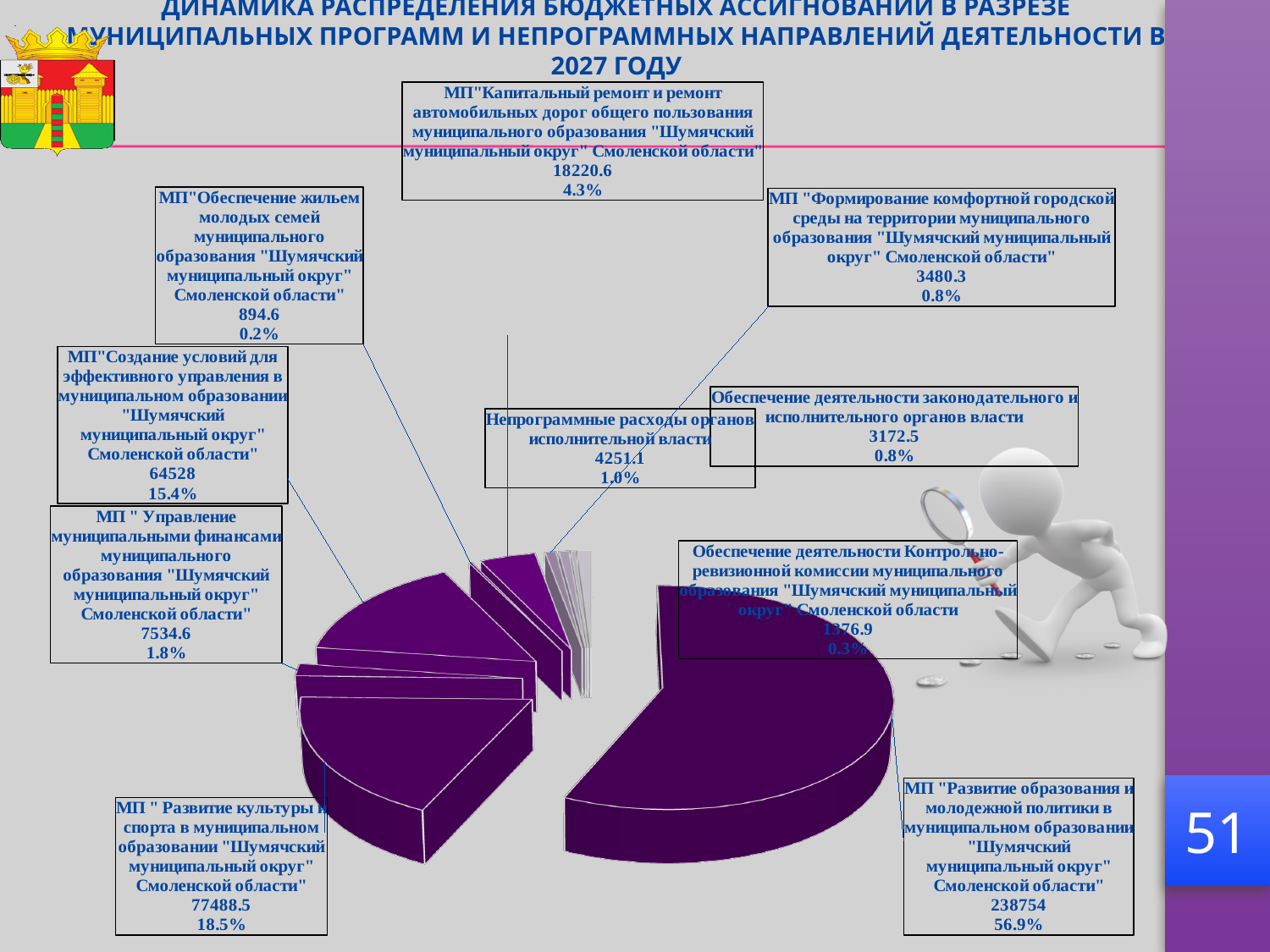
Which is larger: the value for МП "Управление муниципальными финансами" or the value for МП"Капитальный ремонт и ремонт автомобильных дорог"? МП"Капитальный ремонт и ремонт автомобильных дорог" What kind of chart is shown on the slide? Pie chart What share of the pie does МП "Развитие образования и молодежной политики" account for? 56.9% How many categories are shown in the pie chart? 10 What is the difference between the values for МП "Развитие образования и молодежной политики" (238754) and МП "Развитие культуры и спорта" (77488.5)? 161265.5 What is the value shown for МП "Формирование комфортной городской среды"? 3480.3 What share of the pie does МП"Создание условий для эффективного управления в муниципальном образовании" account for? 15.4% Which category has the smallest share of the pie? МП"Обеспечение жильем молодых семей муниципального образования "Шумячский муниципальный округ" Смоленской области" What is the value shown for Непрограммные расходы органов исполнительной власти? 4251.1 What share of the pie does Обеспечение деятельности Контрольно-ревизионной комиссии account for? 0.3% Which category has the largest share of the pie? МП "Развитие образования и молодежной политики в муниципальном образовании "Шумячский муниципальный округ" Смоленской области" What is the value shown for МП "Развитие культуры и спорта в муниципальном образовании "Шумячский муниципальный округ" Смоленской области"? 77488.5